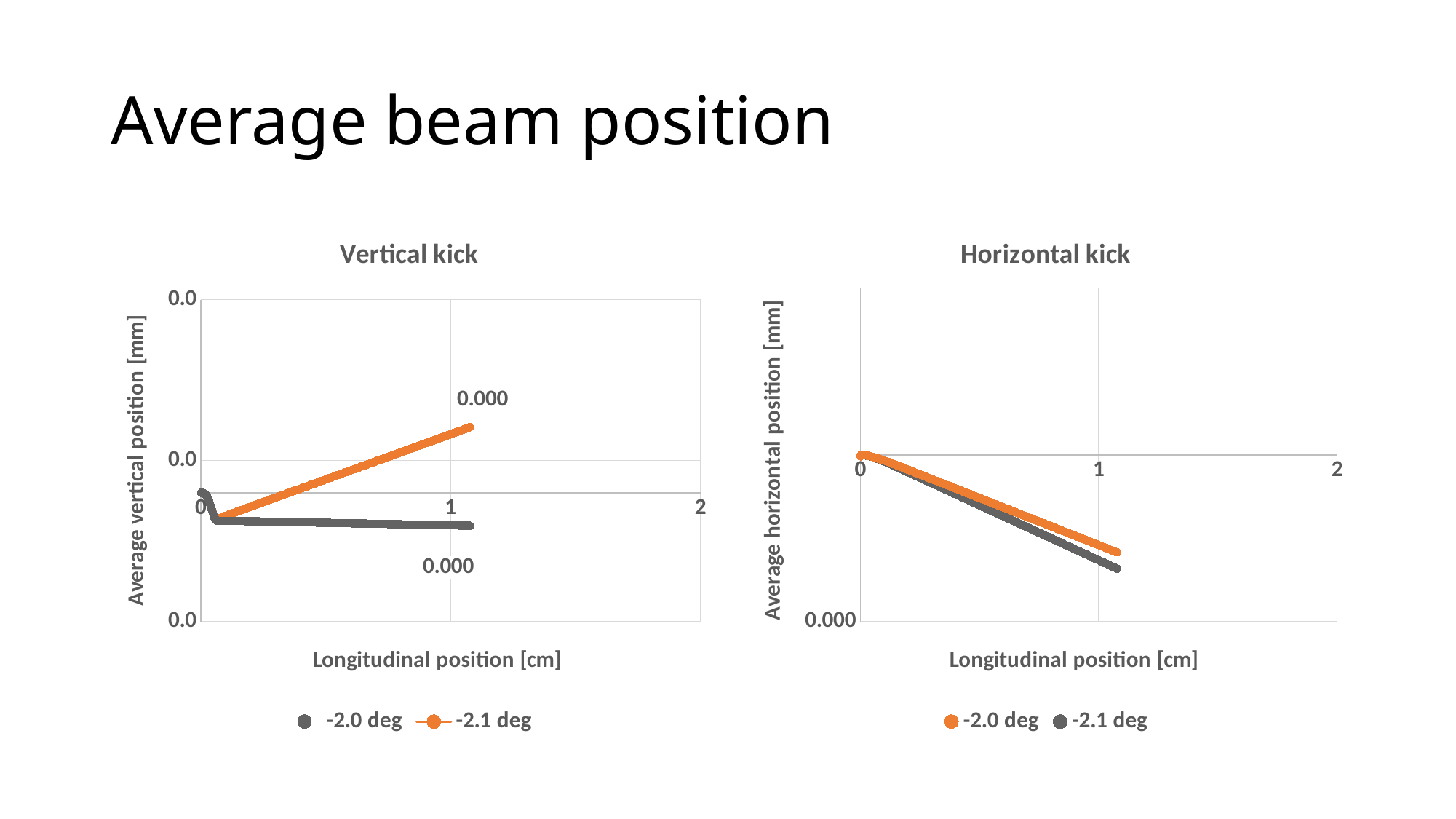
In the Vertical kick chart, what colour is the -2.1 deg series? orange What is the x-axis title of the Horizontal kick chart? Longitudinal position [cm] How many series does the legend of the Horizontal kick chart list? 2 In the Horizontal kick chart, does the -2.0 deg series rise or fall as longitudinal position increases? fall In the Horizontal kick chart, does the -2.1 deg series rise or fall as longitudinal position increases? fall What kind of chart is the Horizontal kick chart? line chart What kind of chart is the Vertical kick chart? line chart How many series does the legend of the Vertical kick chart list? 2 In the Horizontal kick chart, which series is higher at a longitudinal position of 1 cm, -2.0 deg or -2.1 deg? -2.0 deg In the Vertical kick chart, which series is higher at a longitudinal position of 1 cm, -2.0 deg or -2.1 deg? -2.1 deg In the Vertical kick chart, what data label is printed at the end of the -2.1 deg series? 0.000 In the Vertical kick chart, does the -2.1 deg series rise or fall as longitudinal position increases? rise